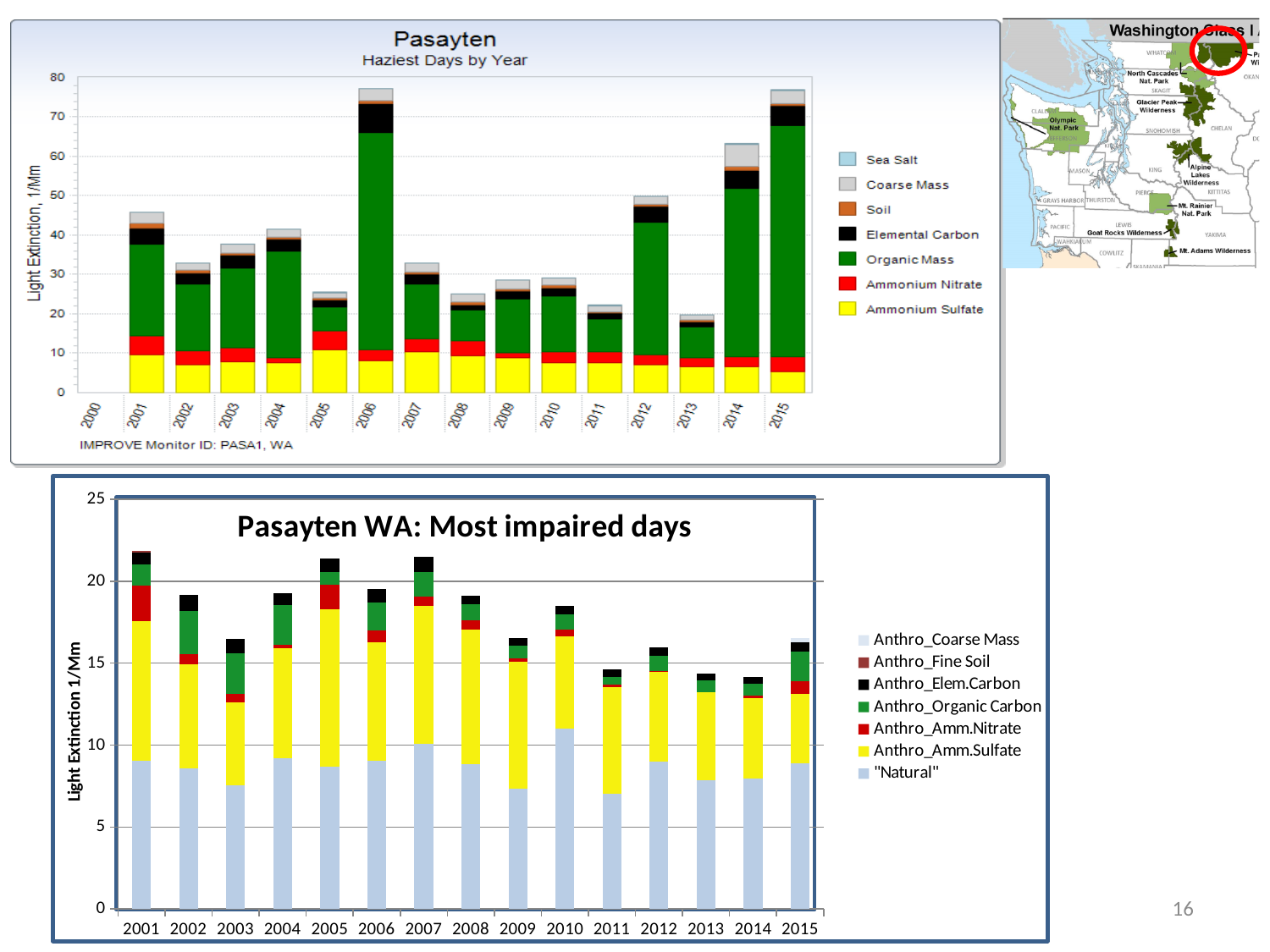
In the bottom chart "Pasayten WA: Most impaired days", how many series does the legend list? 7 In the bottom chart "Pasayten WA: Most impaired days", is the total bar height for 2010 greater or less than 15? greater In the top chart "Pasayten Haziest Days by Year", how many series does the legend list? 7 In the bottom chart "Pasayten WA: Most impaired days", which year has the larger total bar, 2005 or 2011? 2005 In the bottom chart "Pasayten WA: Most impaired days", how many years are shown on the x axis? 15 In the top chart "Pasayten Haziest Days by Year", is the total bar height for 2005 greater or less than 30? less In the top chart "Pasayten Haziest Days by Year", which year has the larger total bar, 2012 or 2013? 2012 In the top chart "Pasayten Haziest Days by Year", is the total bar height for 2006 greater or less than 70? greater In the bottom chart "Pasayten WA: Most impaired days", what is the y-axis label? Light Extinction 1/Mm In the top chart "Pasayten Haziest Days by Year", how many years have a bar plotted? 15 In the top chart "Pasayten Haziest Days by Year", what monitor ID is noted below the x axis? IMPROVE Monitor ID: PASA1, WA What type of chart is the top chart titled "Pasayten Haziest Days by Year"? Stacked bar chart